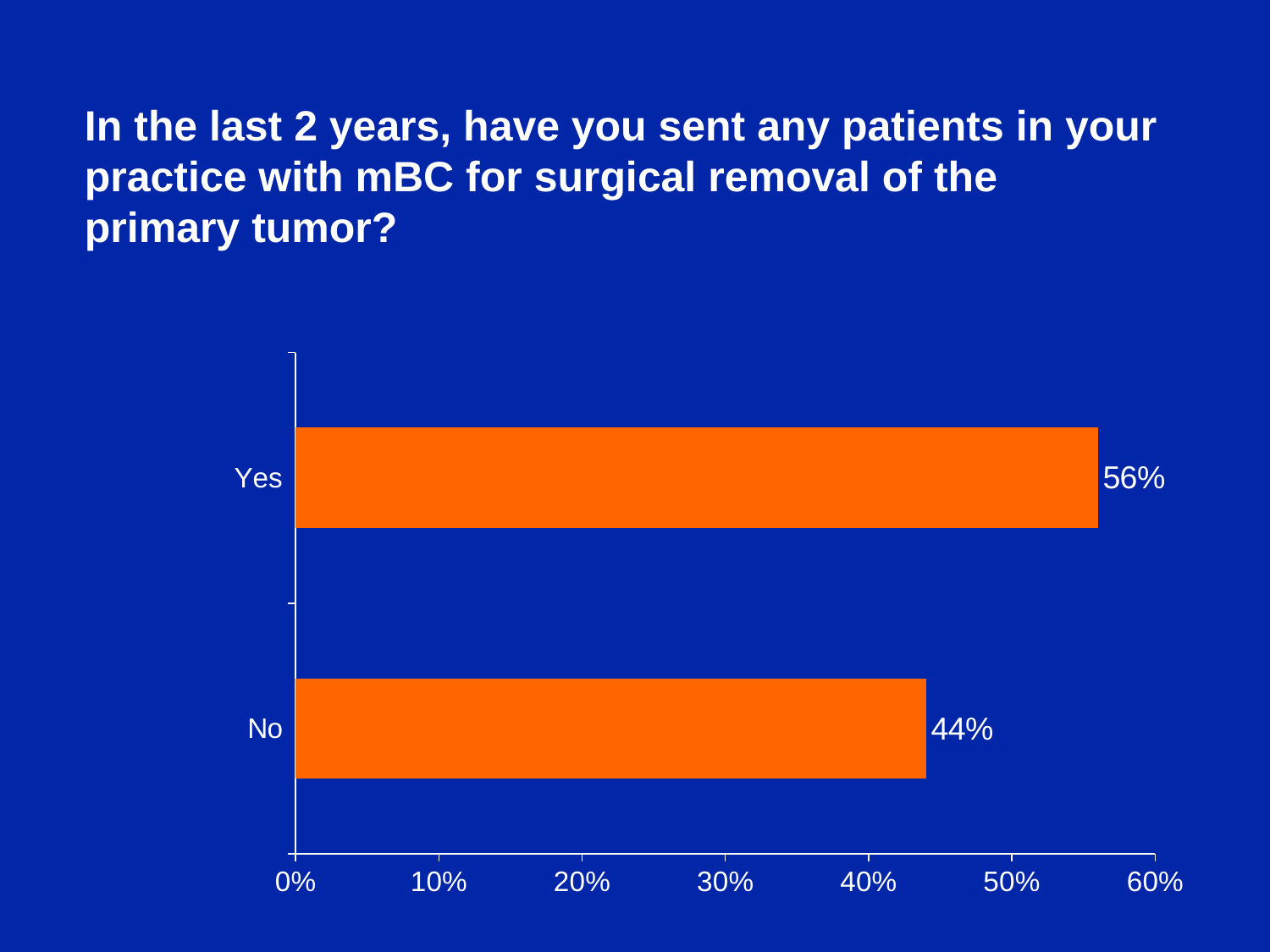
Which response has the lower percentage? No Which response has the higher percentage, Yes or No? Yes What type of chart is shown on the slide? Bar chart What is the total of the Yes and No percentages? 100% How many response categories are shown in the chart? 2 What percentage of respondents answered No? 44% What percentage of respondents answered Yes? 56% What is the difference in percentage points between the Yes and No responses? 12% What is the maximum value shown on the horizontal axis? 60% Is the value for Yes greater or less than 50%? greater Is the value for No greater or less than 50%? less What colour are the bars in the chart? Orange